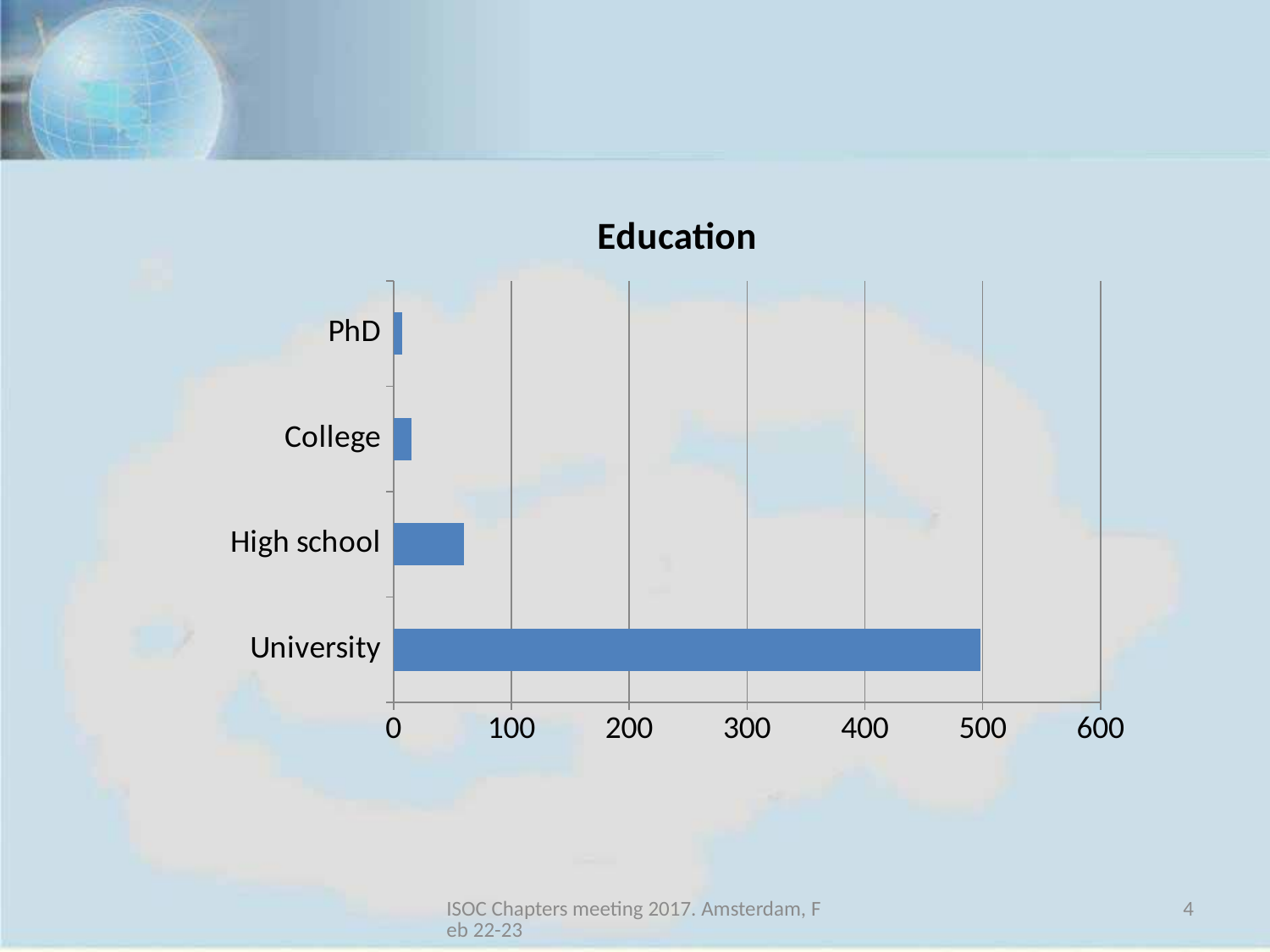
How many categories are shown in the chart? 4 Is the value for University greater or less than 600? less Which is larger, the value for University or the value for High school? University What kind of chart is shown on the slide? bar chart Which category has the highest value? University Is the value for High school greater or less than 100? less Which category has the lowest value? PhD Is the value for College greater or less than 100? less What is the highest value shown on the horizontal axis? 600 Which is larger, the value for High school or the value for College? High school What is the title of the chart? Education